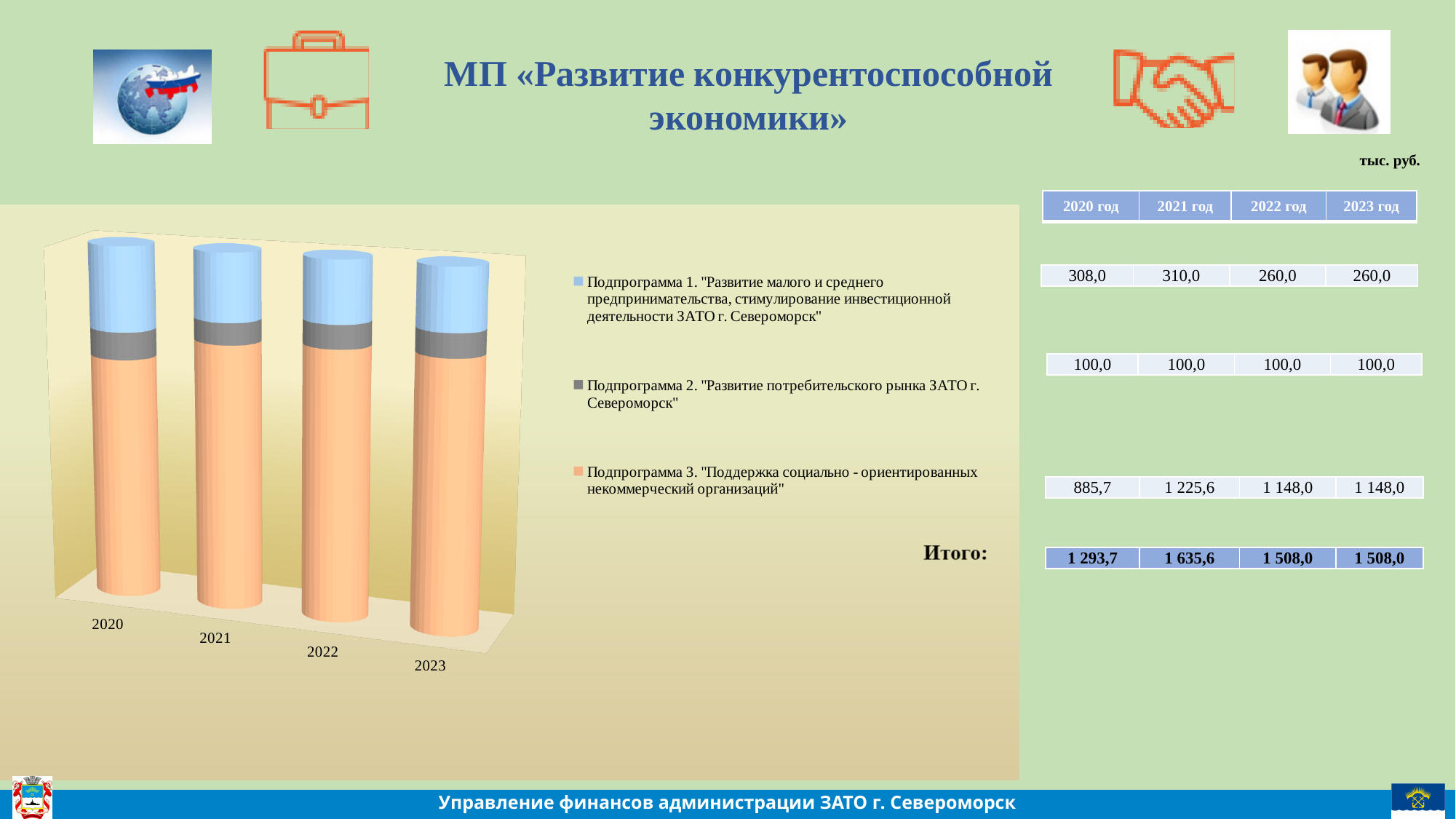
Which year has the lowest total (Итого)? 2020 What is the difference between the Подпрограмма 1 values for 2021 and 2022? 50,0 How many years (categories) are shown along the x axis of the chart? 4 Which year has the highest total (Итого)? 2021 What is the value for Подпрограмма 3 in 2021 (тыс. руб.)? 1 225,6 Which year has the larger value for Подпрограмма 3: 2020 or 2021? 2021 What is the value for Подпрограмма 1 in 2020 (тыс. руб.)? 308,0 What colour represents Подпрограмма 2 in the chart? Grey How many series does the chart legend list? 3 What is the total (Итого) for 2021? 1 635,6 What kind of chart is shown on the slide? Stacked bar chart What is the value for Подпрограмма 2 in 2023 (тыс. руб.)? 100,0